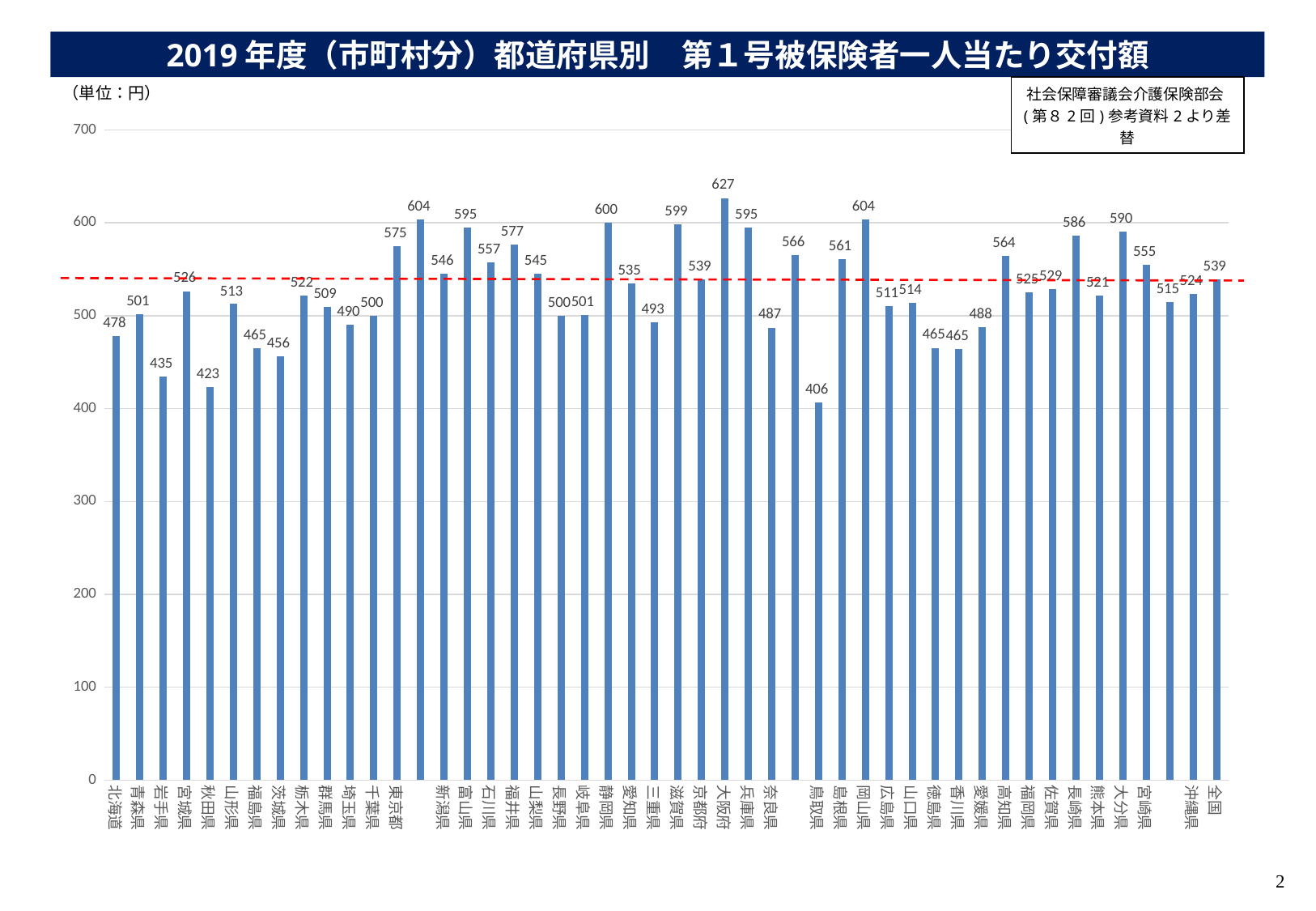
What is the value for 東京都? 575 Which is larger, the value for 福井県 or the value for 石川県? 福井県 Which prefecture has the highest value? 大阪府 What is the difference between the value for 大阪府 and the value for 全国? 88 What is the value for 全国? 539 What kind of chart is shown on the slide? bar chart What unit is stated for the values in the chart? 円 Is the value for 秋田県 greater or less than 500? less What is the value for 北海道? 478 What is the difference between the value for 宮城県 and the value for 秋田県? 103 What is the value for 沖縄県? 524 Which fiscal year does the chart title refer to? 2019年度